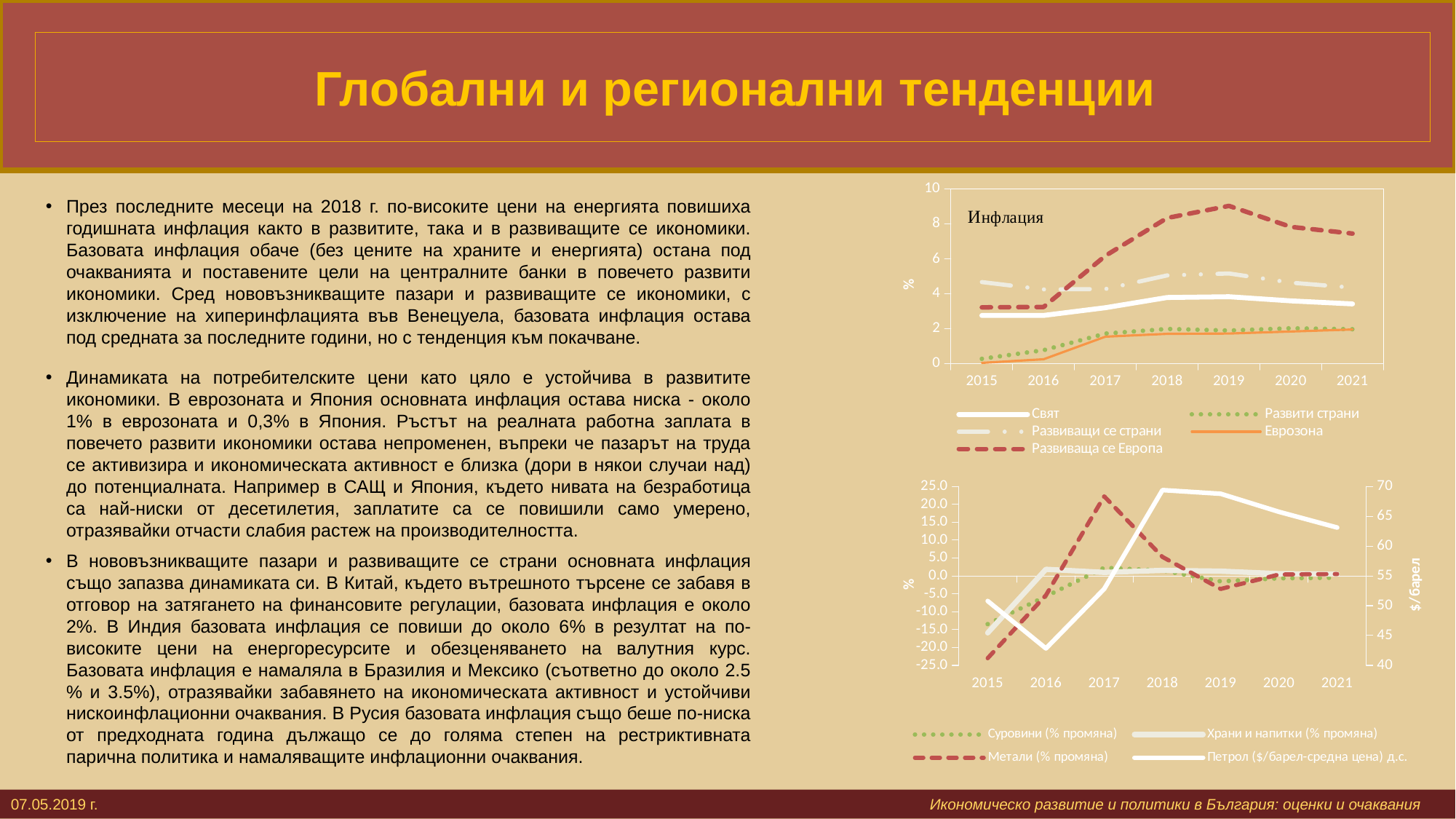
In the top chart "Инфлация", does the Развиваща се Европа line rise or fall from 2019 to 2021? fall How many series does the legend of the bottom chart list? 4 In the top chart "Инфлация", which series has the lowest value in 2015? Еврозона How many years are shown on the x axis of the top chart "Инфлация"? 7 In the bottom chart, in which year does the Метали (% промяна) line reach its highest value? 2017 In the top chart "Инфлация", is the value for Развиваща се Европа in 2019 greater or less than 8? greater What type of chart is the top chart titled "Инфлация"? line chart In the bottom chart, is the value for Метали (% промяна) in 2017 greater or less than 20.0? greater In the bottom chart, what is the label of the right-hand vertical axis? $/барел In the top chart "Инфлация", which series has the highest value in 2019? Развиваща се Европа How many series does the legend of the top chart "Инфлация" list? 5 In the top chart "Инфлация", is the value for Свят in 2015 greater or less than 4? less